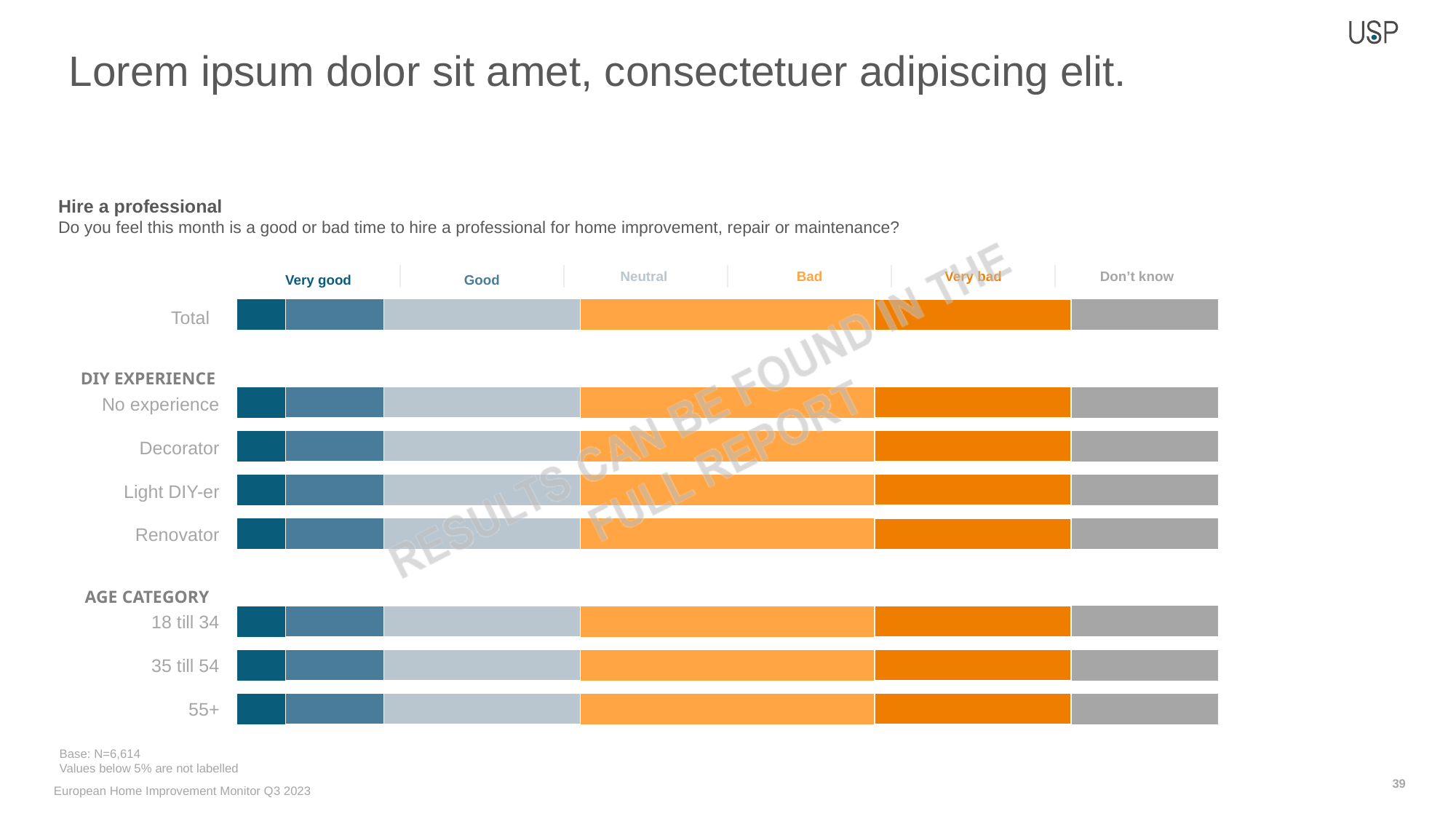
How many bars are shown under the AGE CATEGORY group? 3 How many bars (rows) are plotted in the chart? 8 What kind of chart is shown on the slide? Stacked bar chart What is the base (N) stated below the chart? N=6,614 What is the title of the chart? Hire a professional In the 55+ bar, which segment is wider: Good or Bad? Bad In the Total bar, which segment is wider: Bad or Very bad? Bad How many response categories does the legend of the chart list? 6 How many bars are shown under the DIY EXPERIENCE group? 4 In the Total bar, which segment is wider: Very good or Neutral? Neutral